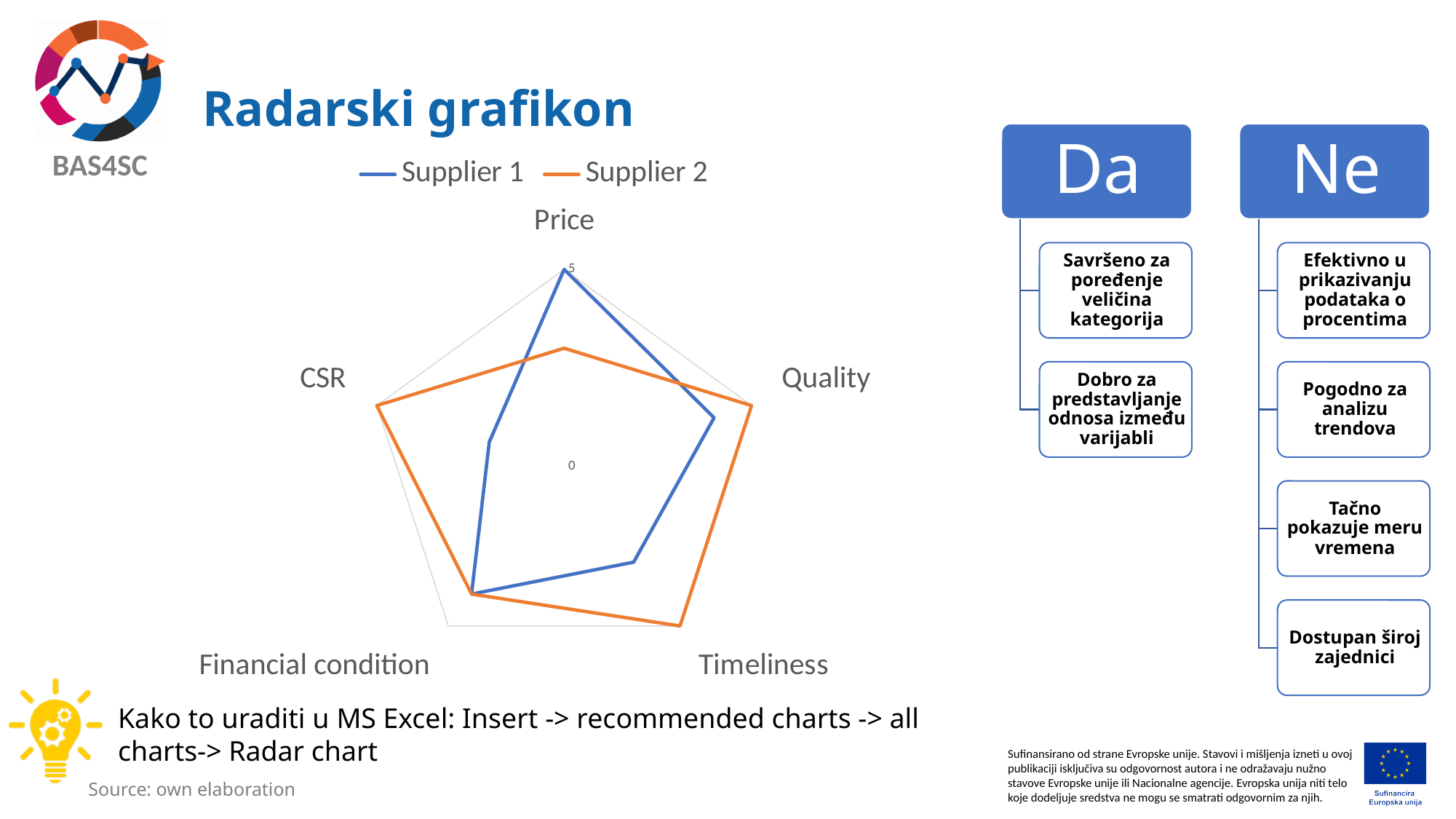
Which supplier has the larger value for Price? Supplier 1 Which series is drawn in orange on the radar chart? Supplier 2 What kind of chart is shown on the slide? Radar chart What is the value of Supplier 2 for CSR? 5 How many series does the legend of the radar chart list? 2 Which supplier has the larger value for Timeliness? Supplier 2 In which category does Supplier 2 have its lowest value? Price What is the value of Supplier 2 for Quality? 5 How many categories (axes) does the radar chart have? 5 In which category does Supplier 1 have its highest value? Price What is the value of Supplier 1 for Price? 5 Which supplier has the larger value for CSR? Supplier 2